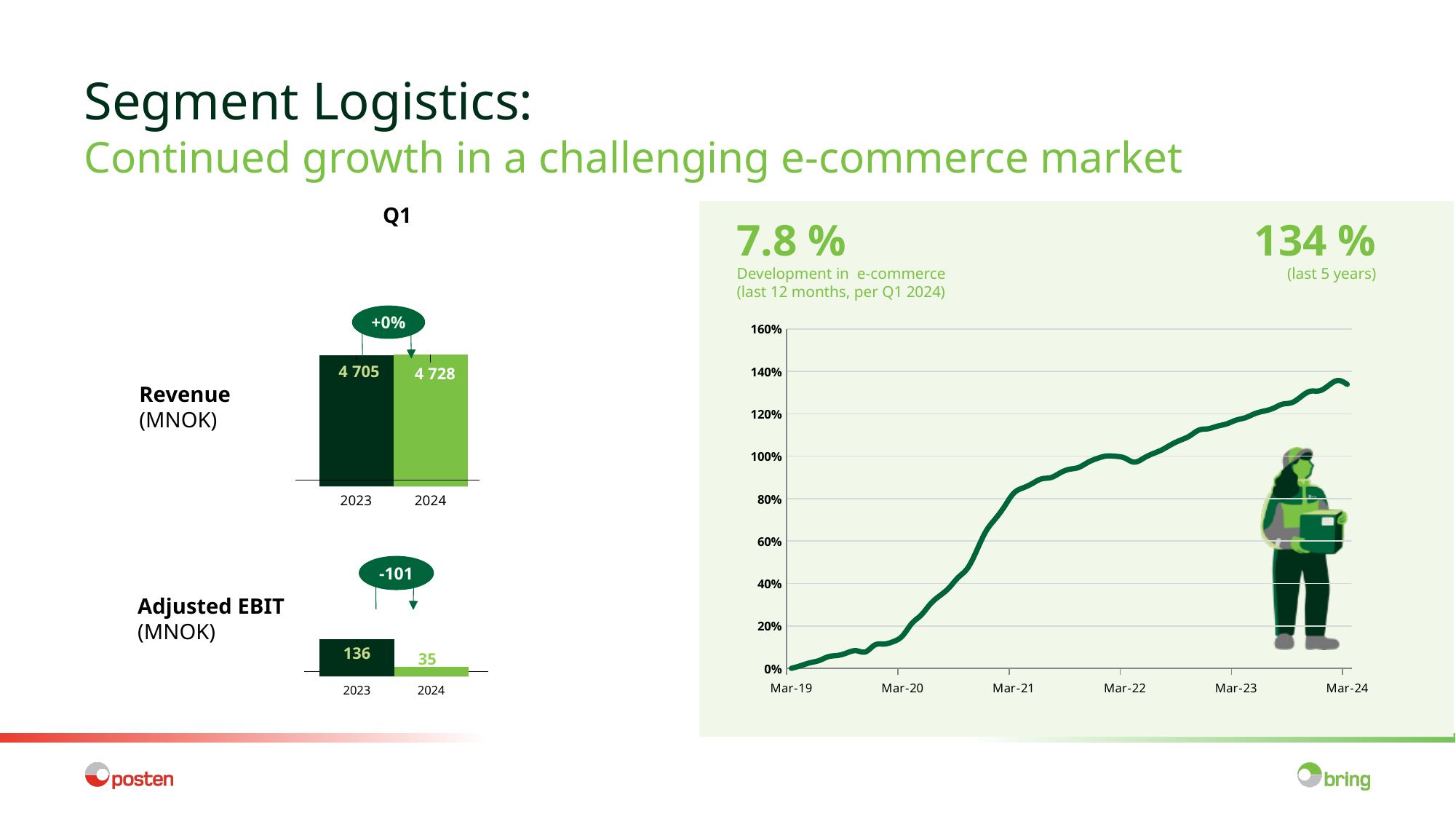
In the Revenue (MNOK) chart, what is the difference between the 2024 and 2023 values? 23 In the Adjusted EBIT (MNOK) chart, what is the difference between the 2023 and 2024 values? 101 In the Adjusted EBIT (MNOK) chart, which year has the higher value, 2023 or 2024? 2023 In the Revenue (MNOK) chart, what is the value for 2023? 4 705 What kind of chart is the Revenue (MNOK) chart? bar chart In the e-commerce development line chart, is the value at Mar-23 greater or less than 100%? greater In the Revenue (MNOK) chart, what is the value for 2024? 4 728 In the Adjusted EBIT (MNOK) chart, what is the value for 2023? 136 In the Adjusted EBIT (MNOK) chart, what is the value for 2024? 35 What kind of chart is the e-commerce development chart on the right? line chart In the e-commerce development line chart, is the value at Mar-20 greater or less than 20%? less In the e-commerce development line chart, do the values generally rise or fall from Mar-19 to Mar-24? rise